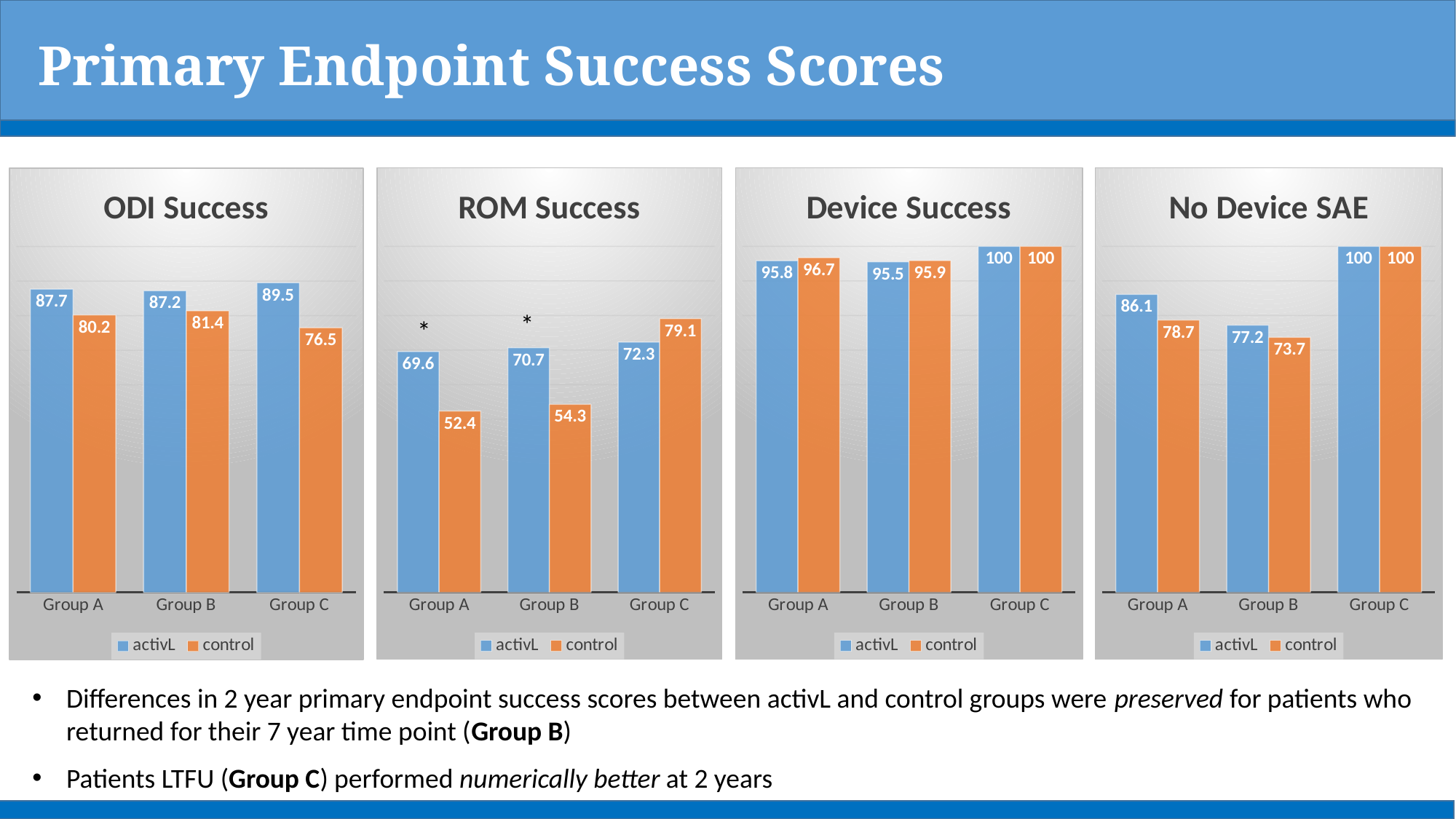
In the ROM Success chart, which is larger for Group C, the activL value or the control value? control How many series does the legend of the ODI Success chart list? 2 In the No Device SAE chart, which group has the highest activL value? Group C In the No Device SAE chart, what is the activL value for Group B? 77.2 In the ROM Success chart, what is the control value for Group A? 52.4 What kind of chart is the ROM Success chart? bar chart In the ODI Success chart, what is the difference between the activL and control values for Group C? 13 How many groups are shown on the x axis of the Device Success chart? 3 In the ROM Success chart, which group has the lowest control value? Group A In the Device Success chart, what is the control value for Group B? 95.9 In the ODI Success chart, what is the activL value for Group C? 89.5 In the ROM Success chart, do the activL values rise or fall from Group A to Group C? rise